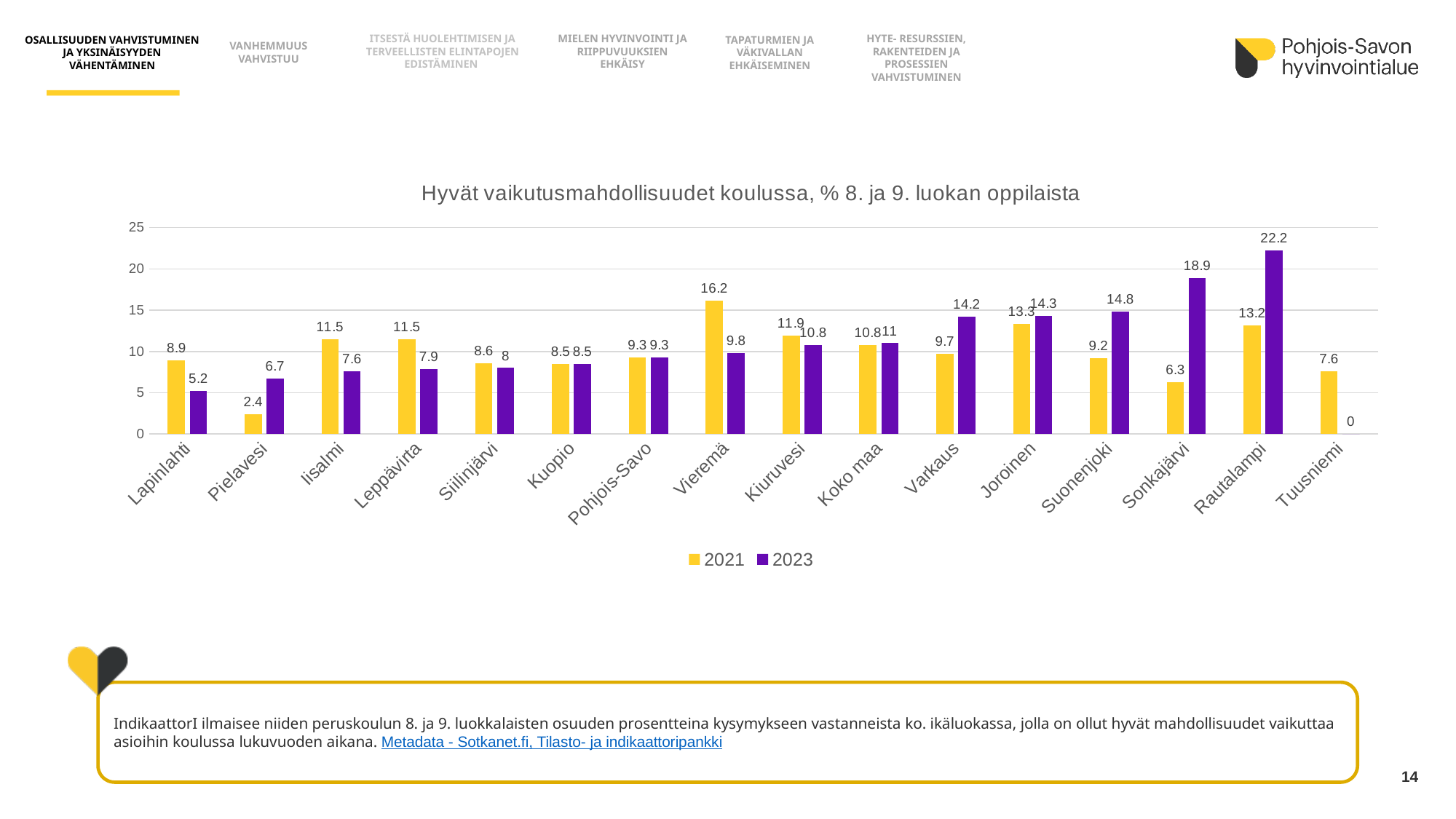
What is the 2023 value for Sonkajärvi? 18.9 What is the 2021 value for Pielavesi? 2.4 Which category has the highest 2021 value? Vieremä Which category has the lowest 2021 value? Pielavesi What is the 2023 value for Rautalampi? 22.2 Which category has the highest 2023 value? Rautalampi What type of chart is shown on the slide? bar chart How many series does the legend list? 2 How many categories are shown on the x axis? 16 Which is larger for Vieremä, the 2021 value or the 2023 value? 2021 What is the difference between the 2023 and 2021 values for Sonkajärvi? 12.6 Is the 2023 value for Rautalampi greater or less than 20? greater